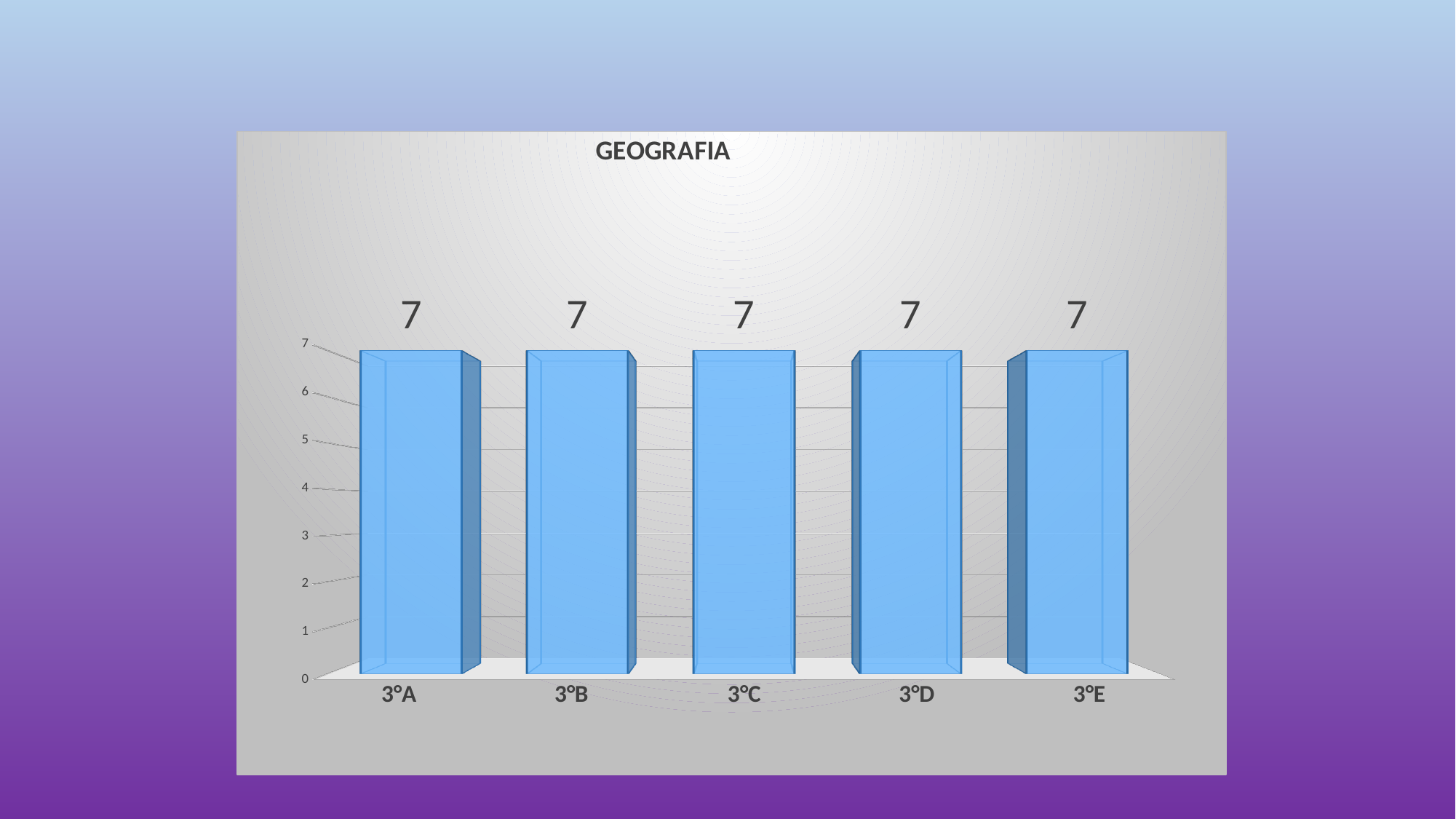
What kind of chart is this? bar chart What is the title of the chart? GEOGRAFIA What colour are the bars? blue What is the value for 3ºC? 7 Is the value for 3ºB greater or less than 5? greater What is the value for 3ºA? 7 Do the values rise, fall or stay the same from 3ºA to 3ºE? stay the same What is the value for 3ºE? 7 What is the highest value shown on the vertical axis? 7 What is the difference between the values for 3ºB and 3ºD? 0 How many categories are shown on the x axis? 5